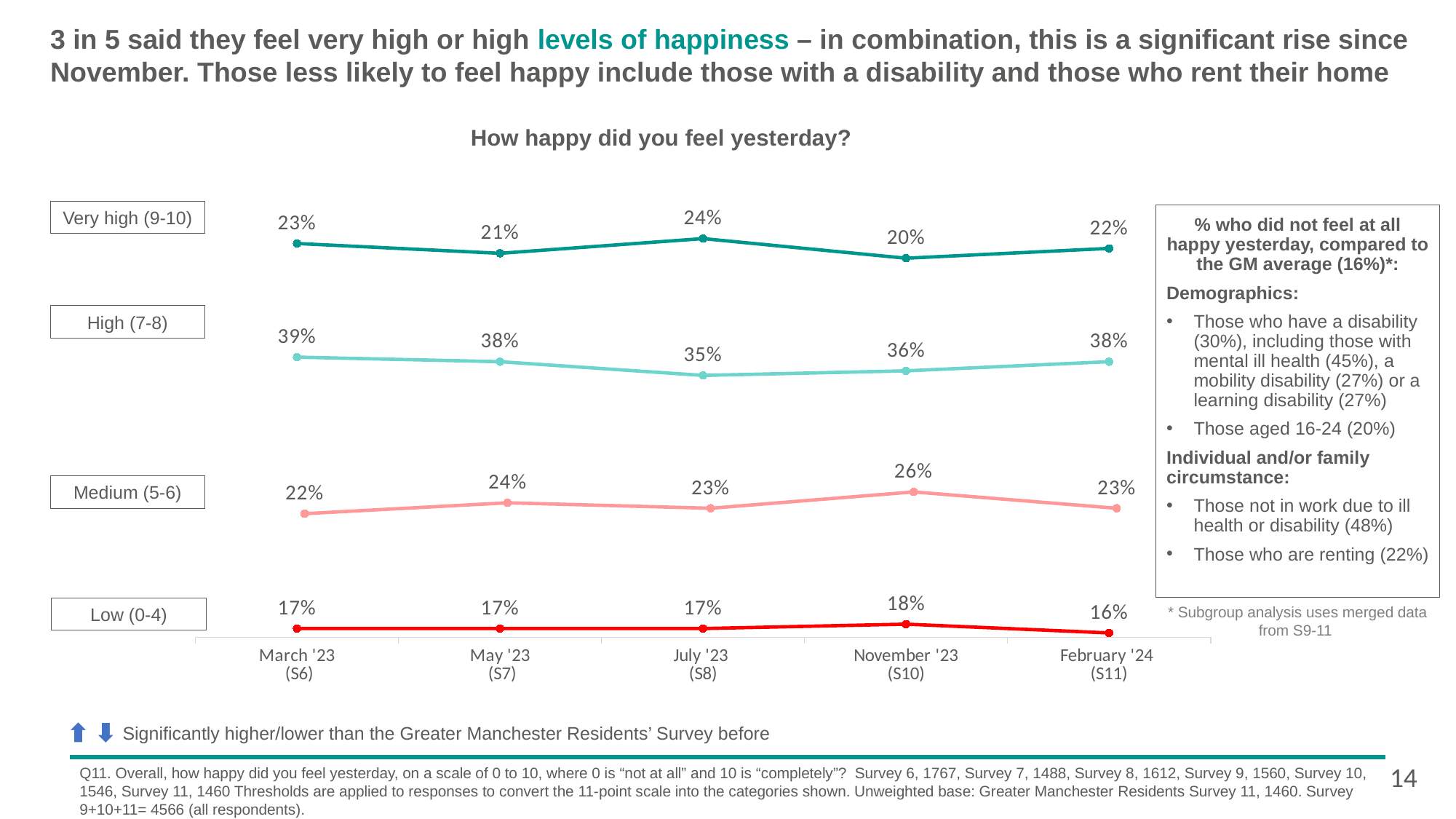
In which survey wave is the High (7-8) value lowest? July '23 (S8) What is the value for Medium (5-6) in July '23 (S8)? 23% What is the title of the chart? How happy did you feel yesterday? What is the value for Low (0-4) in February '24 (S11)? 16% What type of chart is shown on the slide? Line chart How many survey waves are plotted along the x axis? 5 What is the value for Very high (9-10) in November '23 (S10)? 20% In which survey wave is the Very high (9-10) value highest? July '23 (S8) How many series (happiness categories) are plotted on the chart? 4 What is the difference between the High (7-8) value in March '23 (S6) and in July '23 (S8)? 4% What is the value for High (7-8) in March '23 (S6)? 39% Which is larger in November '23 (S10): the Medium (5-6) value or the Very high (9-10) value? Medium (5-6)